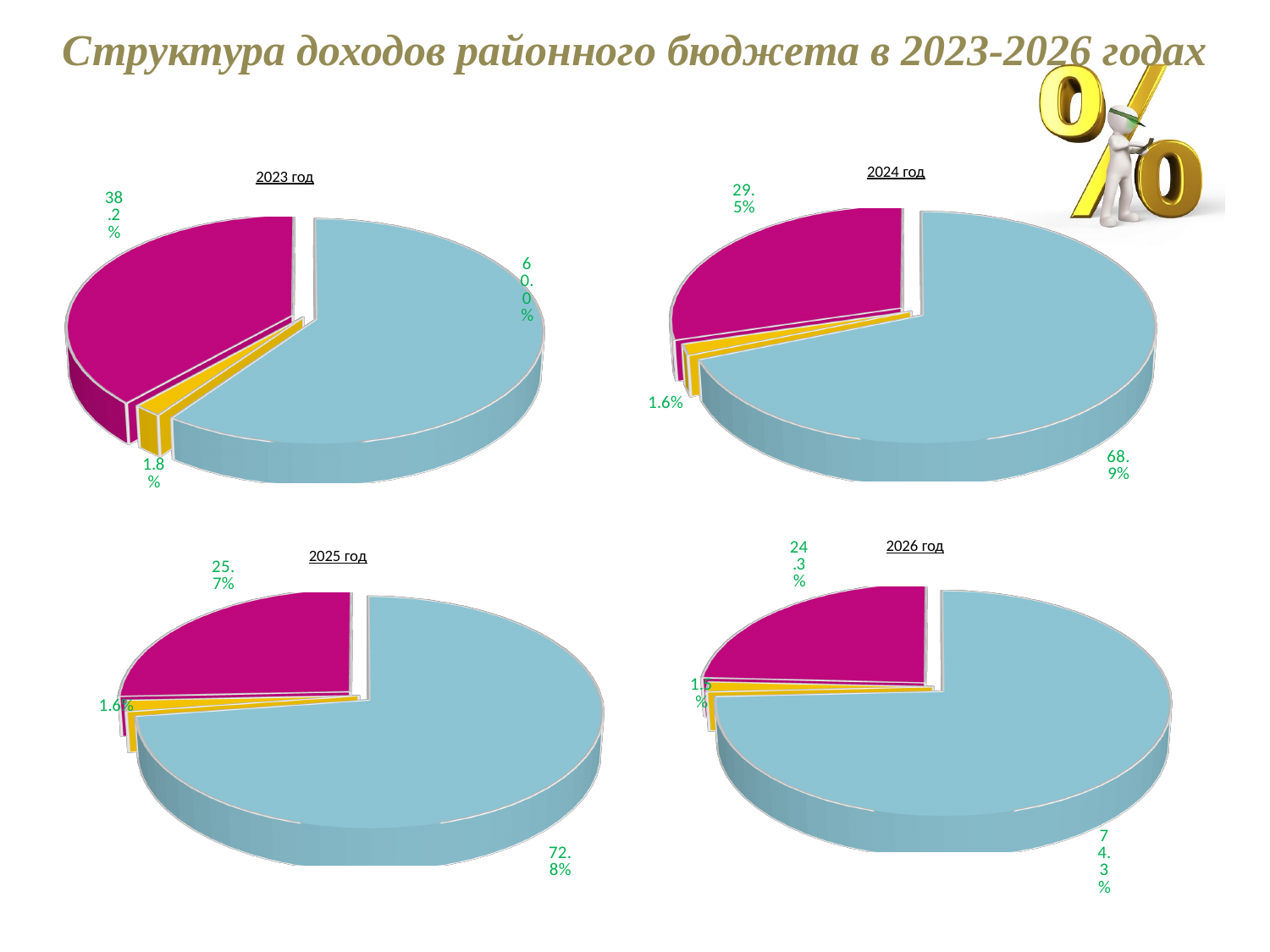
In the 2024 год pie chart, what percentage is shown for the light blue slice? 68.9% In the 2025 год pie chart, what percentage is shown for the light blue slice? 72.8% In the 2026 год pie chart, what percentage is shown for the magenta slice? 24.3% In the 2025 год pie chart, what percentage is shown for the yellow slice? 1.6% What kind of chart is used for 2024 год? pie chart In the 2023 год pie chart, what is the difference between the light blue slice and the magenta slice? 21.8% In the 2023 год pie chart, what percentage is shown for the light blue slice? 60.0% In the 2023 год pie chart, what percentage is shown for the yellow slice? 1.8% In the 2024 год pie chart, what percentage is shown for the magenta slice? 29.5% How many pie charts are on the slide? 4 In the 2023 год pie chart, what percentage is shown for the magenta slice? 38.2% In the 2026 год pie chart, which slice is the largest? the light blue slice (74.3%)